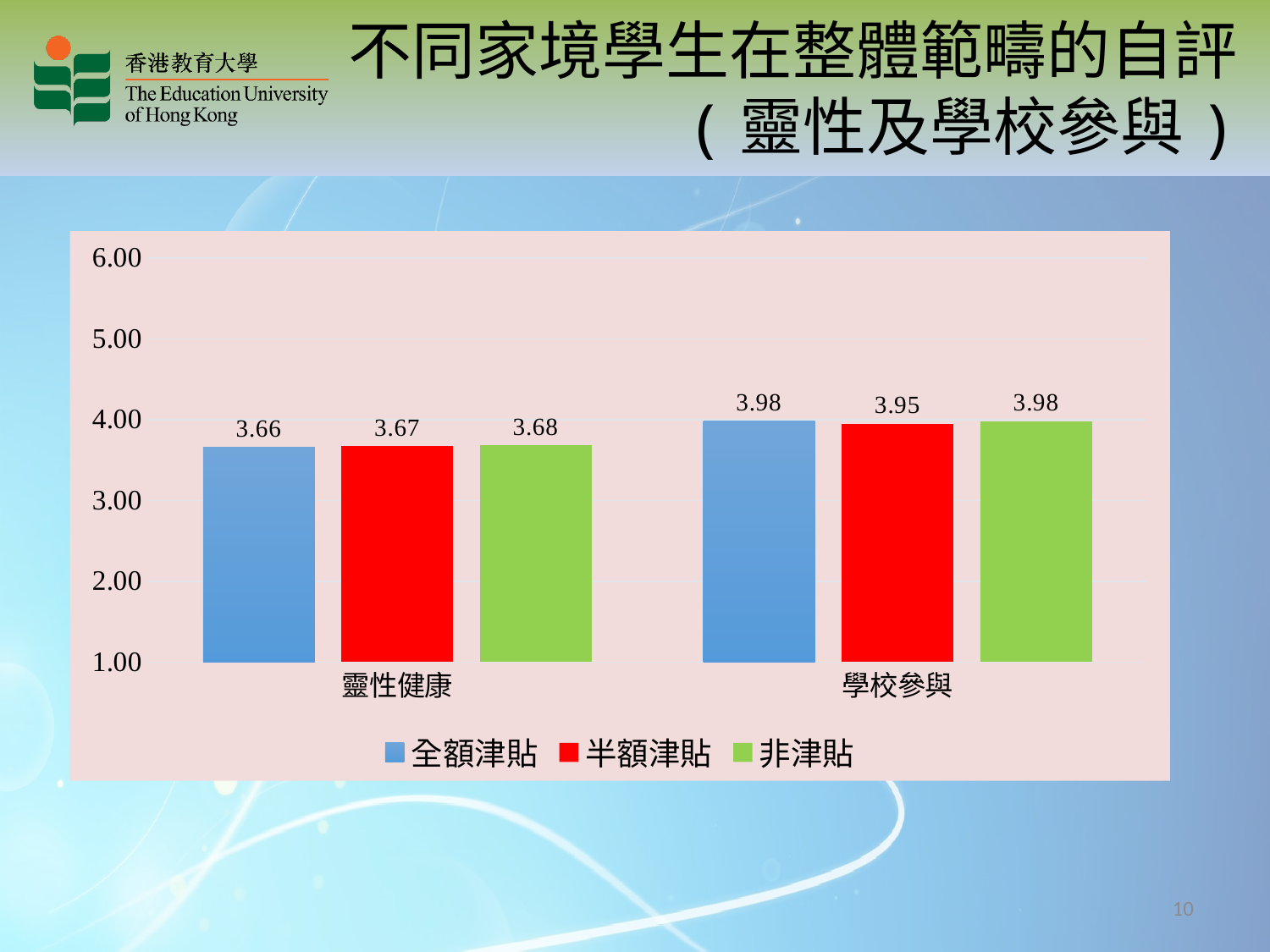
What is the difference between the 全額津貼 value and the 半額津貼 value in the 學校參與 category? 0.03 Which category has the higher value for 半額津貼, 靈性健康 or 學校參與? 學校參與 What is the value for 全額津貼 in the 靈性健康 category? 3.66 What kind of chart is shown on the slide? bar chart What is the difference between the 非津貼 value and the 全額津貼 value in the 靈性健康 category? 0.02 What is the value for 全額津貼 in the 學校參與 category? 3.98 What is the value for 半額津貼 in the 學校參與 category? 3.95 Is the value for 非津貼 in the 靈性健康 category greater or less than 4.00? less How many series does the legend list? 3 How many categories are shown on the x axis? 2 What is the value for 非津貼 in the 靈性健康 category? 3.68 Which colour represents the 半額津貼 series? red